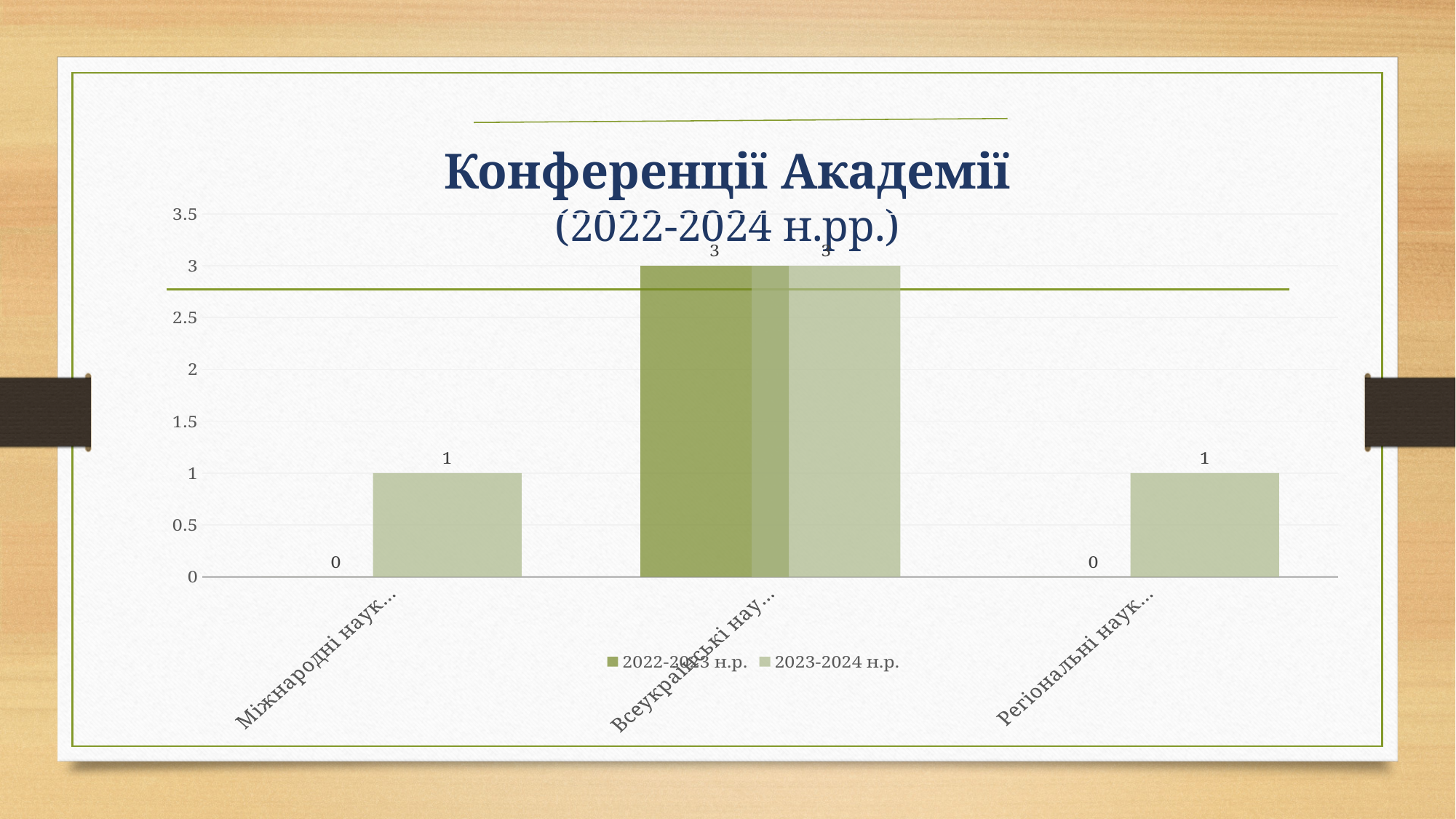
How many categories are shown on the x axis? 3 What are the two series listed in the legend? 2022-2023 н.р. and 2023-2024 н.р. What kind of chart is shown on the slide? bar chart What is the value for the 2023-2024 н.р. series in the "Міжнародні наук..." category? 1 Which is larger in the "Міжнародні наук..." category: the 2022-2023 н.р. value or the 2023-2024 н.р. value? 2023-2024 н.р. Which category has the highest value for the 2023-2024 н.р. series? Всеукраїнські нау... How many series does the legend list? 2 What is the value for the 2022-2023 н.р. series in the "Міжнародні наук..." category? 0 What is the value for the 2022-2023 н.р. series in the "Всеукраїнські нау..." category? 3 What is the title of the chart? Конференції Академії (2022-2024 н.рр.) What is the difference between the 2023-2024 н.р. value and the 2022-2023 н.р. value in the "Регіональні наук..." category? 1 What is the value for the 2023-2024 н.р. series in the "Регіональні наук..." category? 1